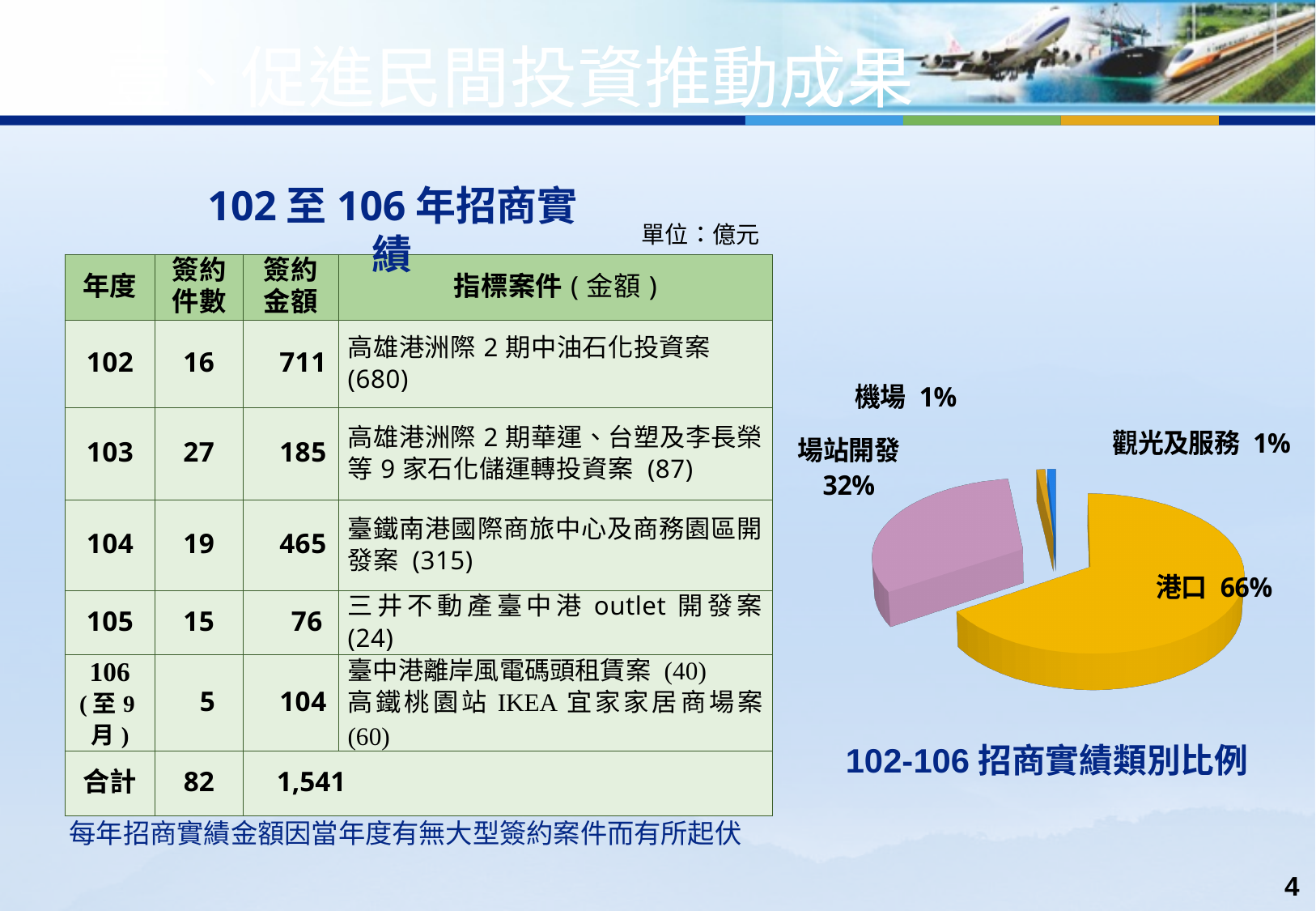
What is the combined share of 港口 and 場站開發? 98% Which category has the largest slice of the pie? 港口 How many slices does the pie chart have? 4 What share of the pie does 機場 account for? 1% What is the title of the pie chart? 102-106 招商實績類別比例 What share of the pie does 港口 account for? 66% Which slice is larger, 場站開發 or 港口? 港口 What is the difference in percentage points between the 港口 slice and the 場站開發 slice? 34 What share of the pie does 觀光及服務 account for? 1% What kind of chart is shown on the slide? pie chart What colour is the 港口 slice of the pie? yellow What share of the pie does 場站開發 account for? 32%